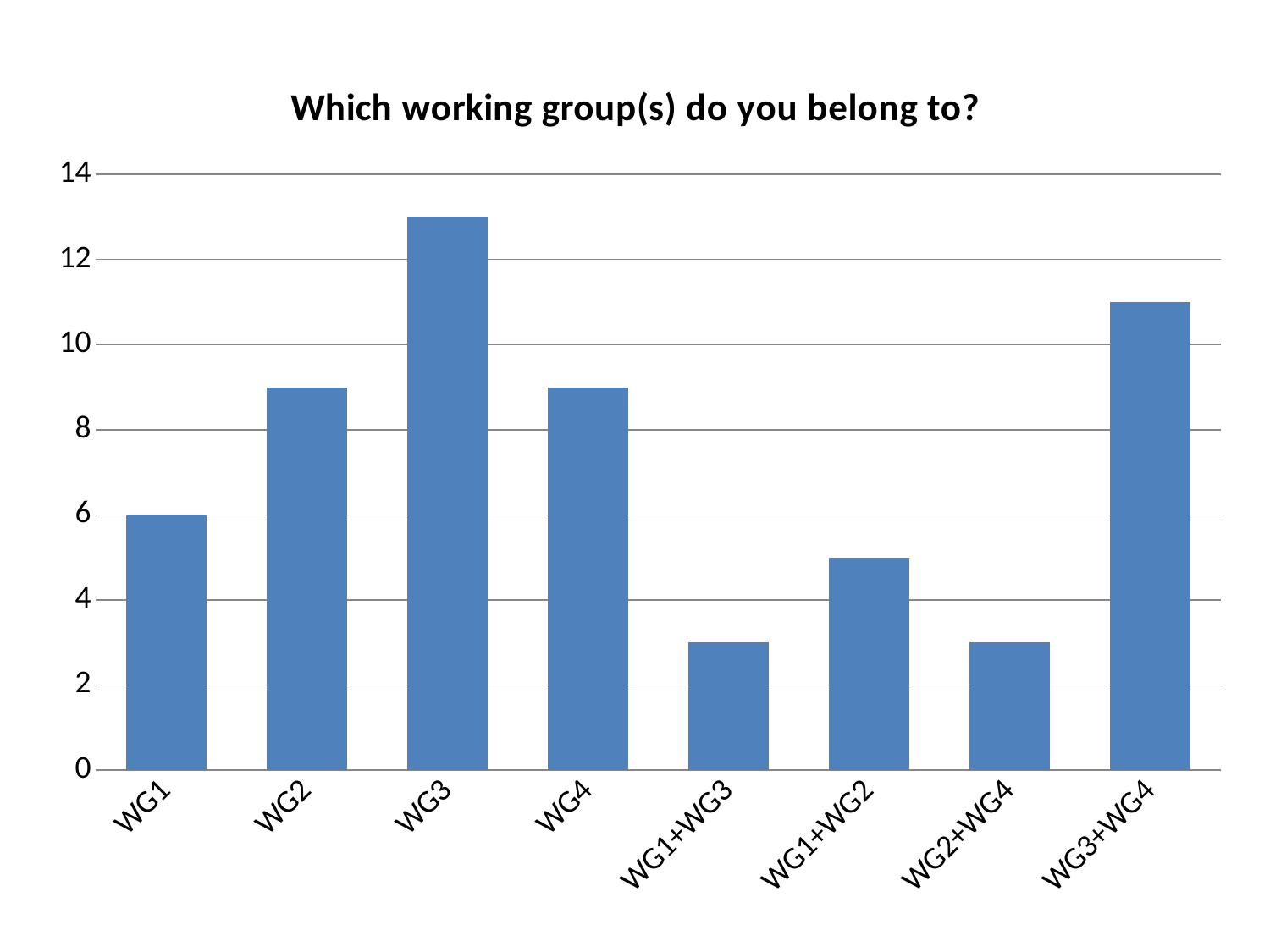
How many categories are shown on the x axis? 8 Is the value for WG3+WG4 greater or less than 10? greater Which is larger, the value for WG4 or the value for WG3+WG4? WG3+WG4 What is the value for WG1? 6 Is the value for WG1+WG3 greater or less than 4? less Which is larger, the value for WG3 or the value for WG3+WG4? WG3 Is the value for WG1+WG2 greater or less than 6? less Which category has the highest value? WG3 What is the title of the chart? Which working group(s) do you belong to? What kind of chart is shown on the slide? bar chart